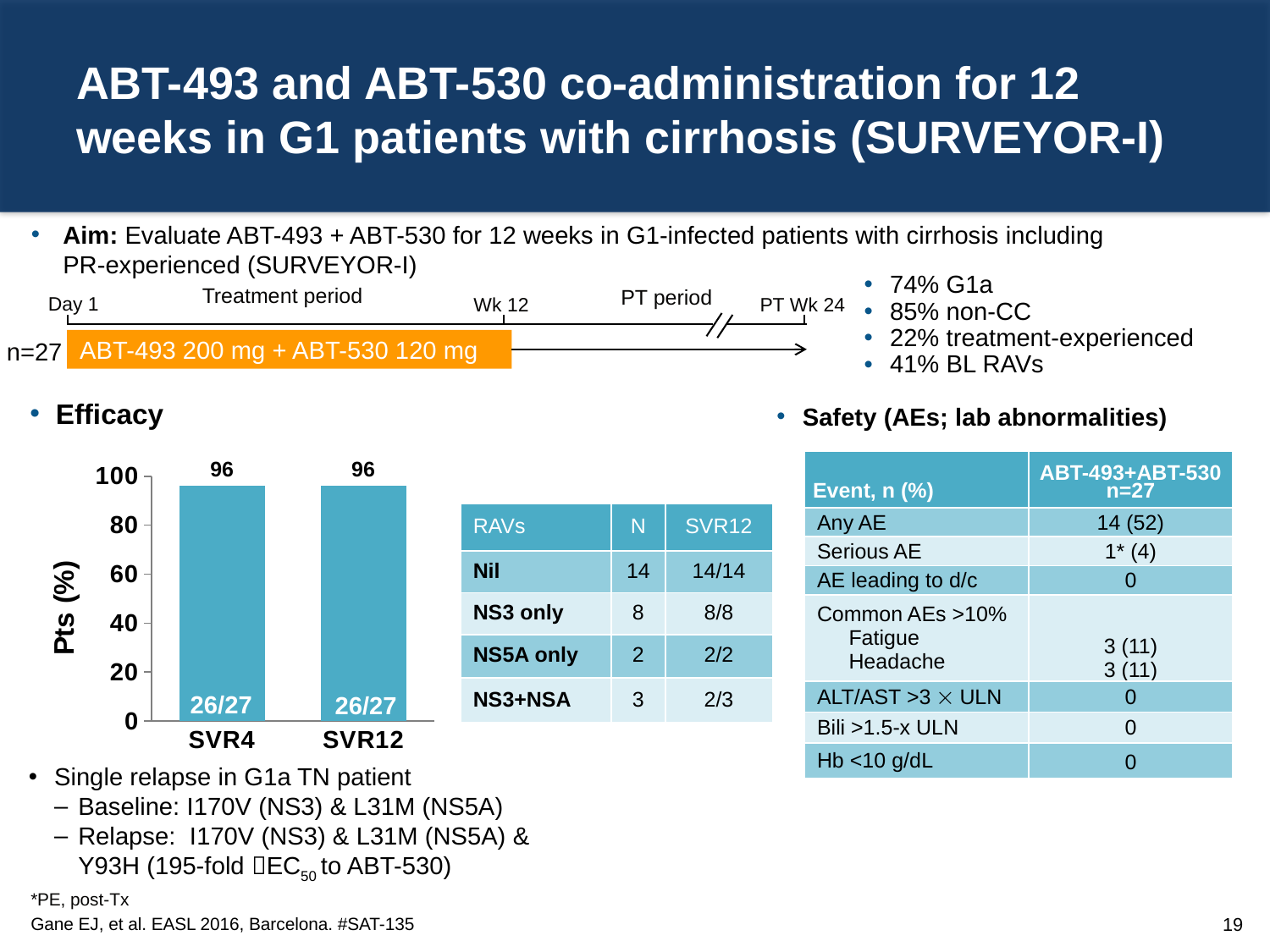
What is the value for SVR4 in the Efficacy bar chart? 96 Do the values rise, fall or stay the same from SVR4 to SVR12 in the bar chart? stay the same What fraction of patients is printed inside the SVR12 bar? 26/27 What is the label of the y axis in the Efficacy bar chart? Pts (%) How many categories are shown on the x axis of the Efficacy bar chart? 2 Is the value for SVR4 greater or less than 100? less Is the value for SVR12 greater or less than 80? greater What fraction of patients is printed inside the SVR4 bar? 26/27 What is the difference between the SVR4 and SVR12 values in the bar chart? 0 What is the value for SVR12 in the Efficacy bar chart? 96 What is the maximum value shown on the y axis of the Efficacy bar chart? 100 What kind of chart is used to show the Efficacy results? bar chart